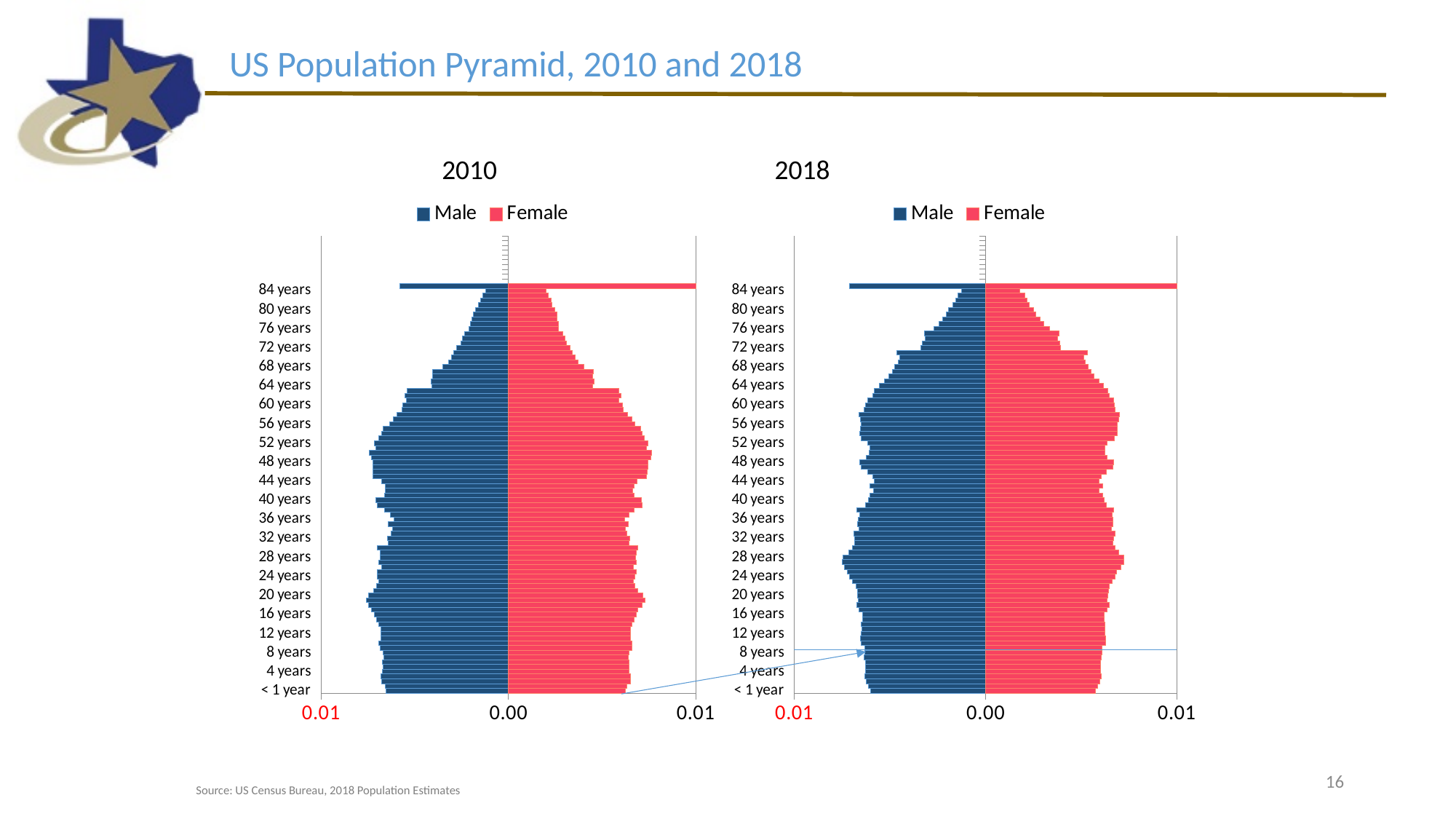
In the 2010 chart, is the Female value for 48 years greater or less than 0.01? less In the 2018 chart, which is larger: the Female value for 60 years or the Female value for 80 years? 60 years How many series does the legend of the 2018 chart list? 2 In the 2010 chart, which colour represents the Female series? Red What are the two series named in the legend of the 2010 chart? Male and Female What kind of chart is the 2010 chart? Bar chart In the 2010 chart, which is larger: the Female value for 72 years or the Female value for 48 years? 48 years In the 2018 chart, do the Male bars generally get shorter or longer going from 64 years up to 80 years? Shorter In the 2018 chart, is the Male value for 28 years greater or less than 0.01? less